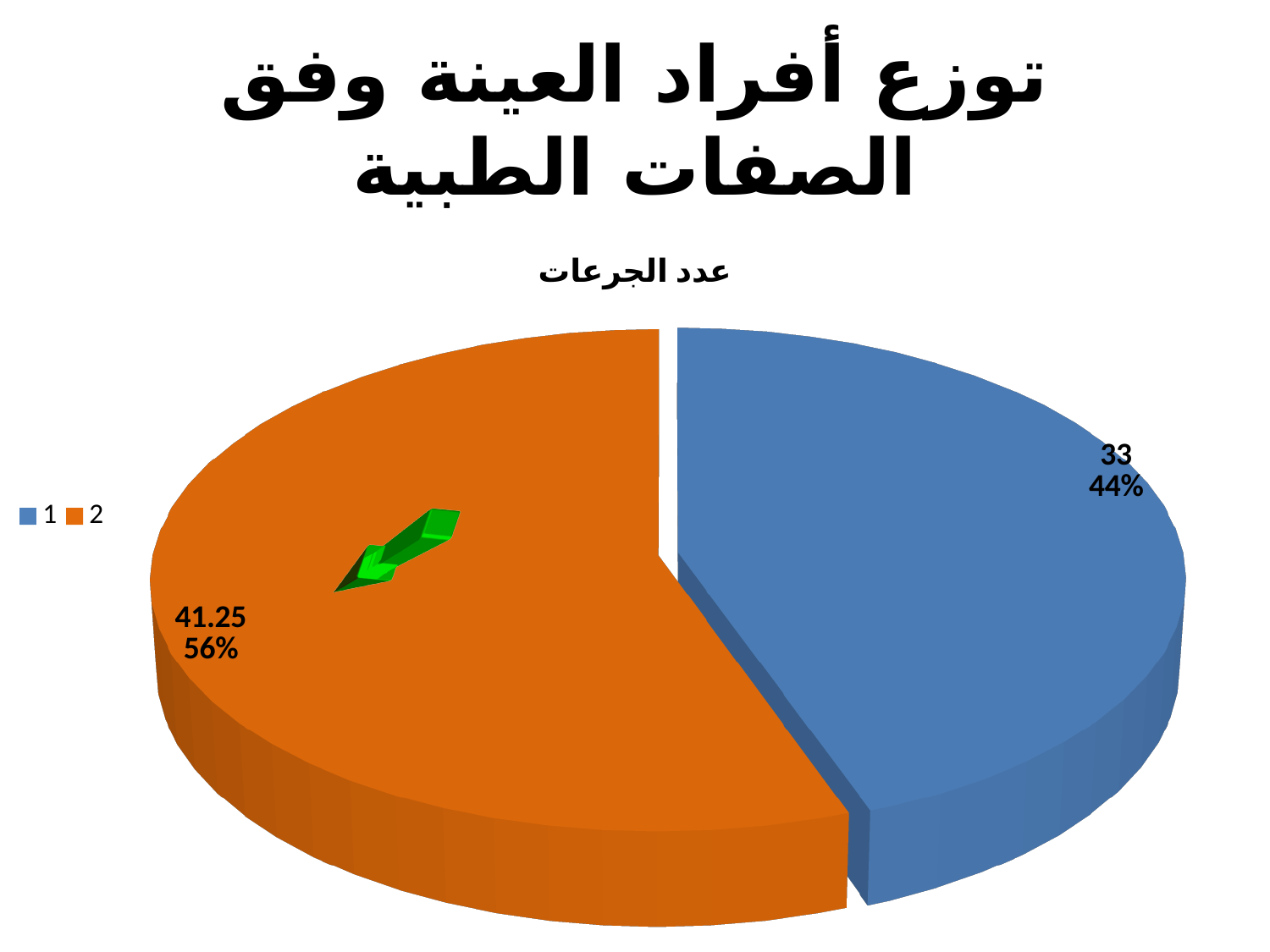
What is the difference between the values for category 2 and category 1? 8.25 What share of the pie does category 2 represent? 56% How many entries does the legend list? 2 Which category has the smallest slice in the pie chart? 1 What colour is the slice for category 2? orange What share of the pie does category 1 represent? 44% What is the value for category 2 in the pie chart? 41.25 Which category has the largest slice in the pie chart? 2 Which is larger, the value for category 1 or category 2? 2 What kind of chart is shown on the slide? pie chart What is the value for category 1 in the pie chart? 33 How many slices does the pie chart have? 2